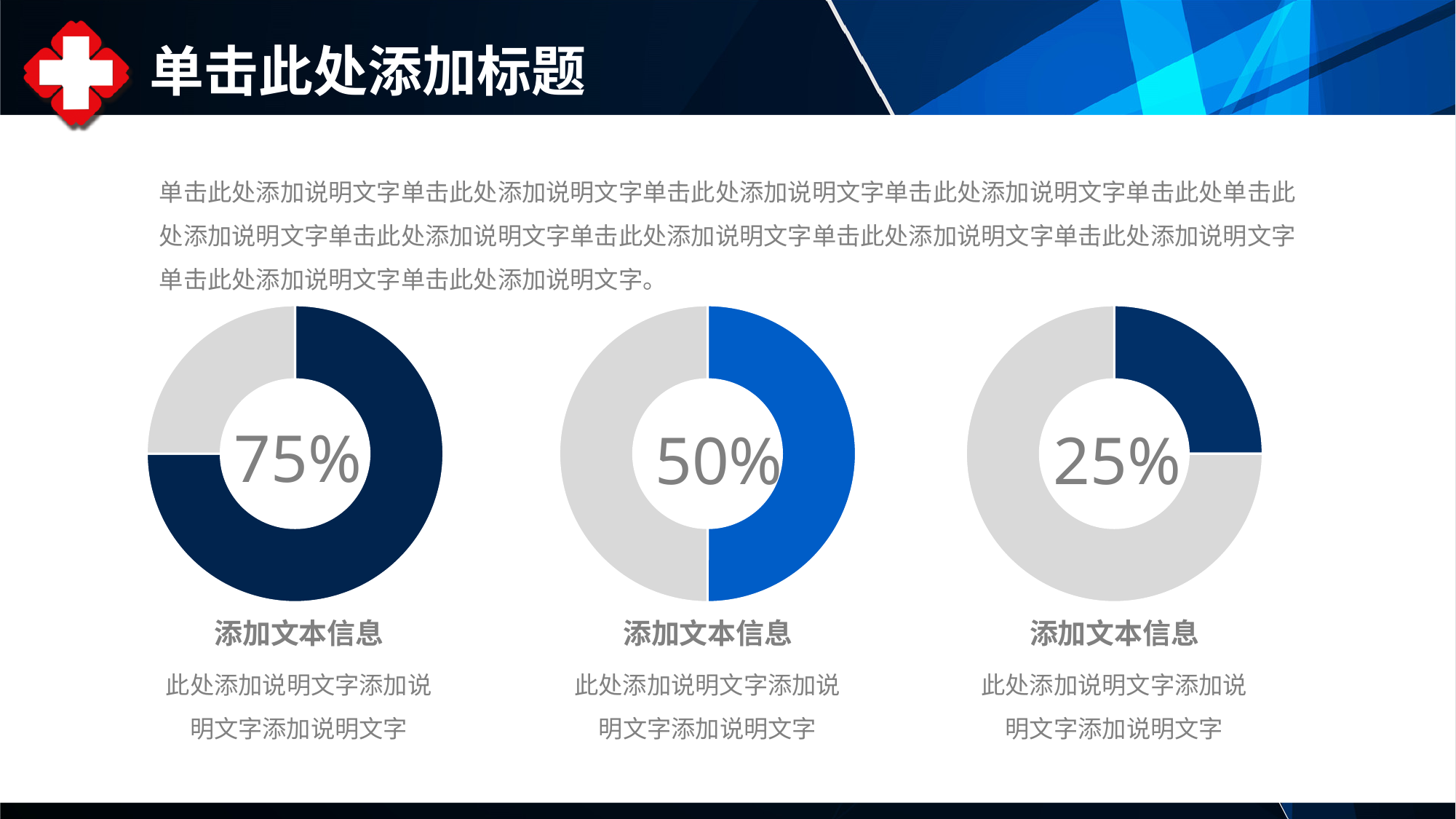
What kind of chart is used for the three figures on the slide? donut chart What percentage is shown in the centre of the right donut chart? 25% What is the difference between the percentage in the middle donut chart and the percentage in the right donut chart? 25% What is the difference between the percentage in the left donut chart and the percentage in the right donut chart? 50% Do the percentages in the donut charts rise or fall from left to right across the slide? fall How many donut charts are on the slide? 3 What colour is the filled portion of the middle donut chart? blue Is the percentage in the middle donut chart larger or smaller than the percentage in the left donut chart? smaller What percentage is shown in the centre of the middle donut chart? 50% Which of the three donut charts shows the highest percentage: left, middle or right? left What percentage is shown in the centre of the left donut chart? 75% Which of the three donut charts shows the lowest percentage: left, middle or right? right